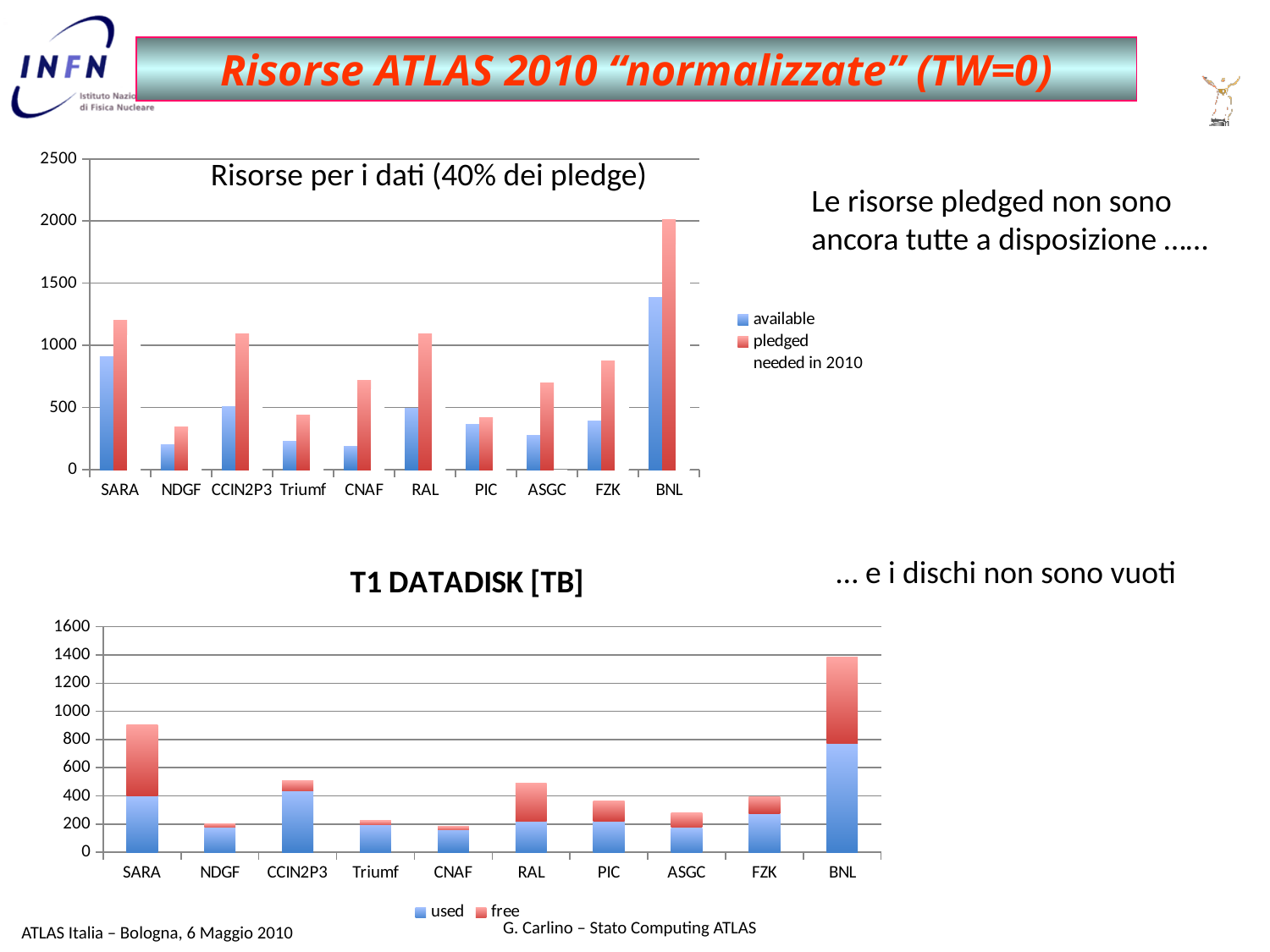
In the top chart "Risorse per i dati (40% dei pledge)", is the pledged value for SARA greater or less than 1000? greater In the bottom chart "T1 DATADISK [TB]", which colour represents the "used" series? blue In the top chart "Risorse per i dati (40% dei pledge)", which is larger for RAL: the available value or the pledged value? pledged In the top chart "Risorse per i dati (40% dei pledge)", which site has the highest available value? BNL In the top chart "Risorse per i dati (40% dei pledge)", which site has the highest pledged value? BNL What kind of chart is the top chart titled "Risorse per i dati (40% dei pledge)"? bar chart In the top chart "Risorse per i dati (40% dei pledge)", how many sites are shown on the x axis? 10 In the bottom chart "T1 DATADISK [TB]", which site has the tallest stacked bar? BNL In the bottom chart "T1 DATADISK [TB]", how many series does the legend list? 2 In the bottom chart "T1 DATADISK [TB]", is the total stacked bar for SARA greater or less than 800? greater In the top chart "Risorse per i dati (40% dei pledge)", is the available value for PIC greater or less than 500? less In the top chart "Risorse per i dati (40% dei pledge)", which site has the lowest pledged value? NDGF